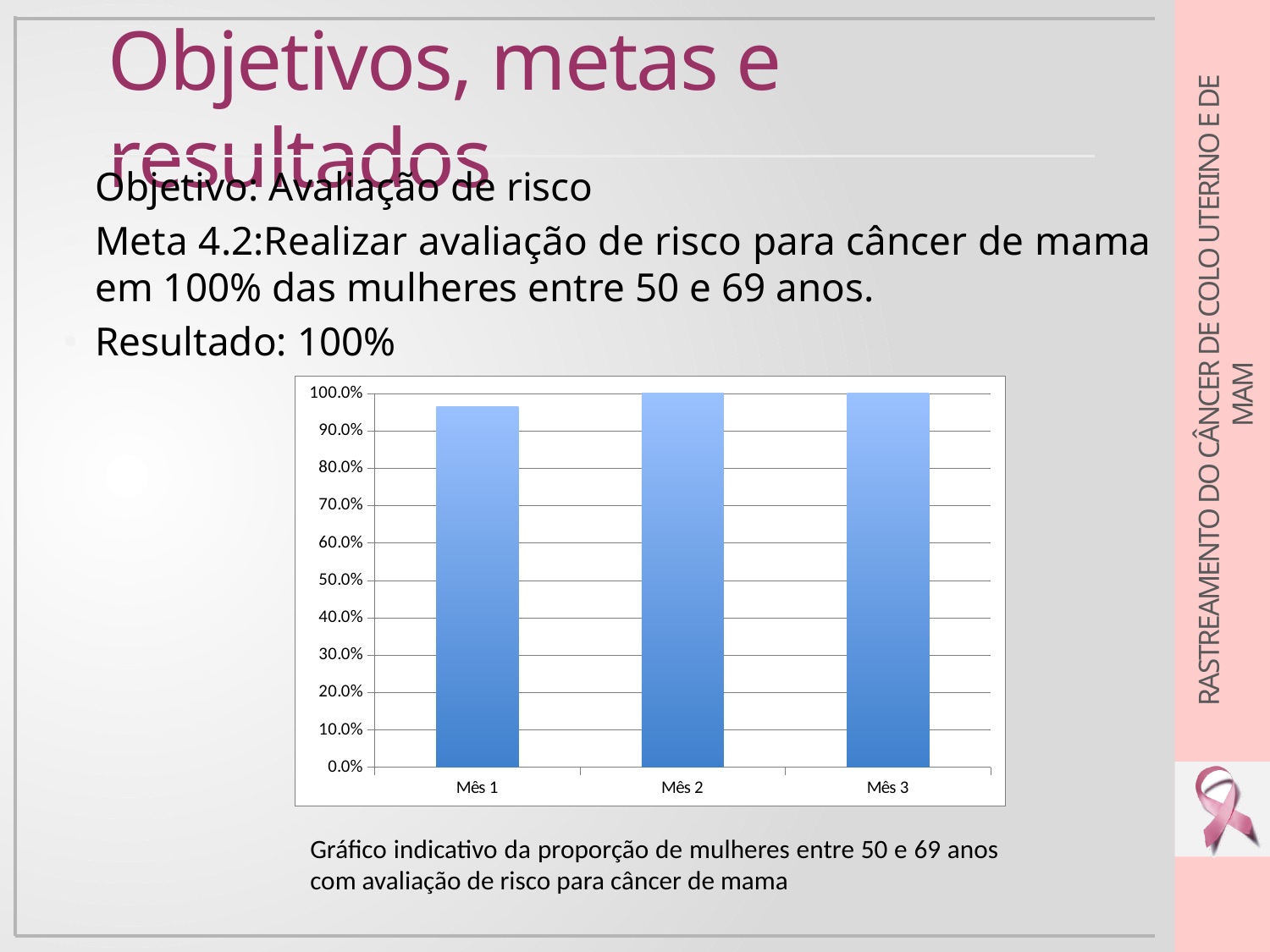
Is the value for Mês 1 greater or less than 100.0%? less What is the label of the first category on the horizontal axis? Mês 1 Which month has the lowest value on the chart? Mês 1 What is the highest value shown on the vertical axis of the chart? 100.0% What is the value for Mês 3? 100.0% What is the value for Mês 2? 100.0% Does the value rise or fall from Mês 1 to Mês 2? rise Which is larger, the value for Mês 1 or the value for Mês 2? Mês 2 What kind of chart is shown on the slide? bar chart Is the value for Mês 1 greater or less than 90.0%? greater How many categories (months) are plotted on the chart? 3